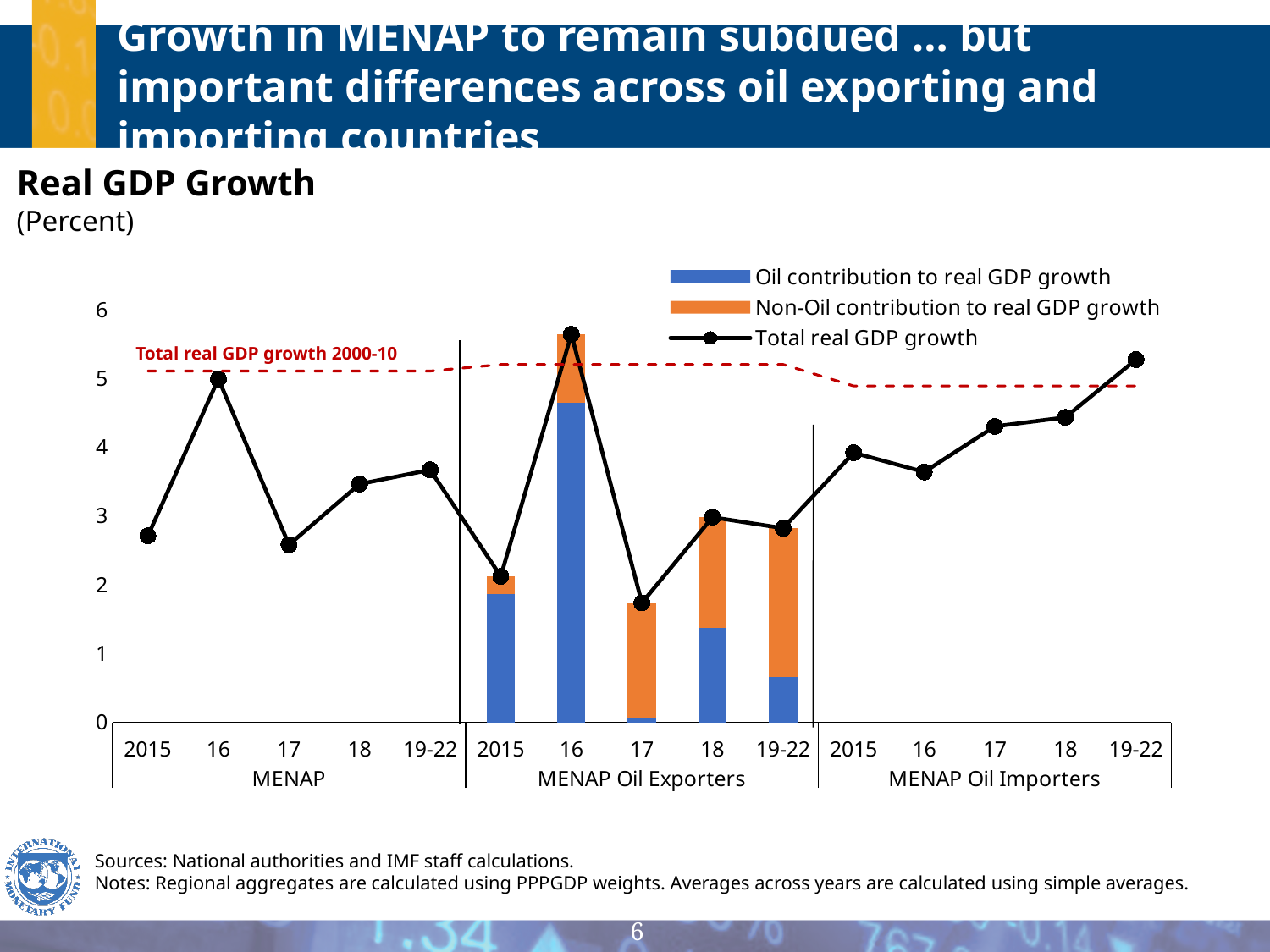
Which is larger: total real GDP growth in 18 for MENAP Oil Exporters or for MENAP Oil Importers? MENAP Oil Importers Is the total real GDP growth for MENAP Oil Exporters in 17 greater or less than 2? less For MENAP Oil Exporters, which period has the lowest total real GDP growth? 17 How many time periods are plotted for each country group? 5 Is the total real GDP growth for MENAP Oil Exporters in 16 greater or less than 5? greater How many country groups are shown along the x axis? 3 What does the red dashed line represent? Total real GDP growth 2000-10 For MENAP, which period has the highest total real GDP growth? 16 For MENAP Oil Importers, which period has the highest total real GDP growth? 19-22 For MENAP Oil Exporters, which period has the highest total real GDP growth? 16 How many series does the legend list? 3 What kind of chart is shown on the slide? A combined line and stacked bar chart